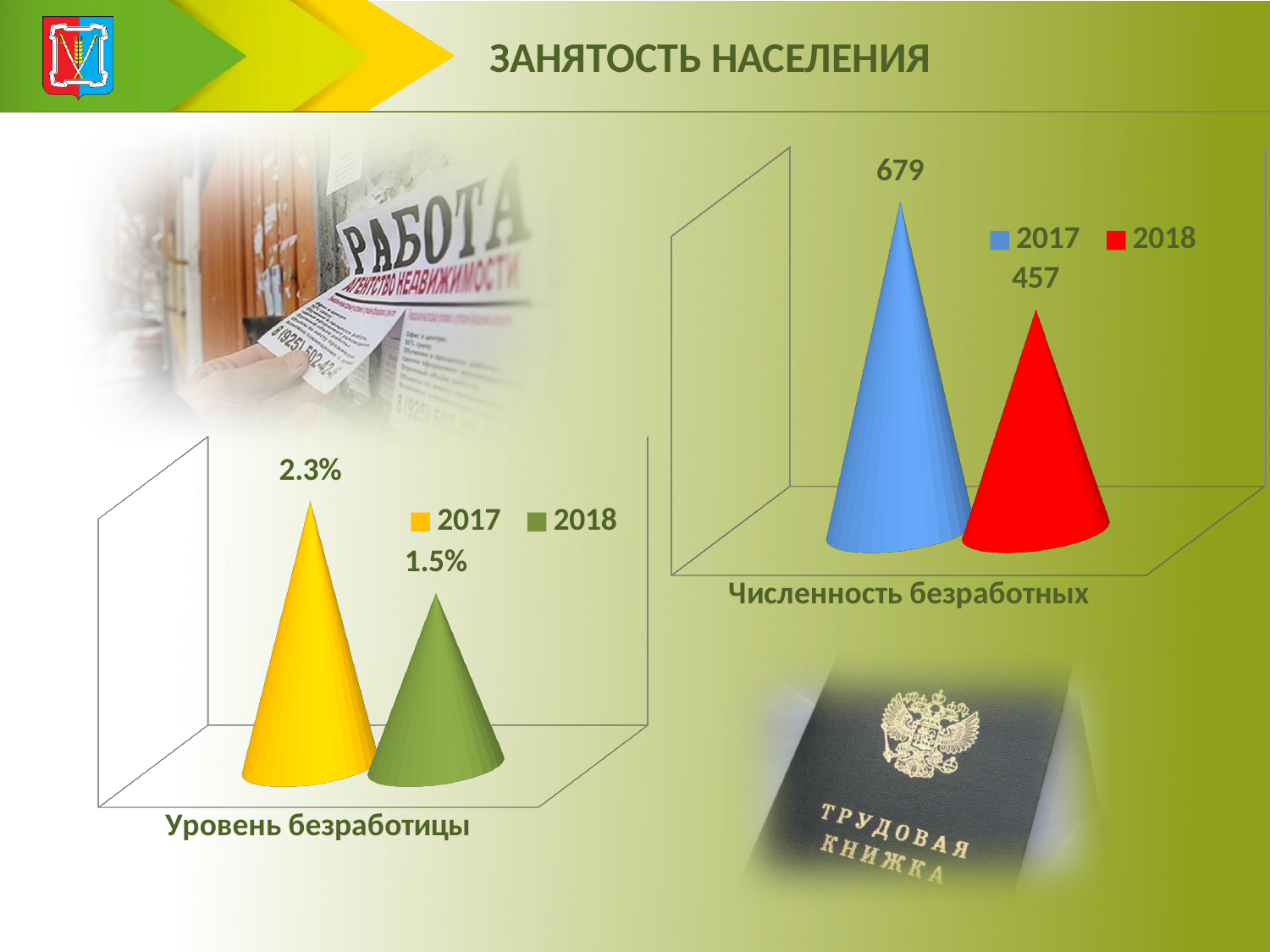
In the chart titled "Уровень безработицы", what is the difference between the 2017 and 2018 values? 0.8% How many series does the legend of the chart titled "Численность безработных" list? 2 In the chart titled "Численность безработных", what is the difference between the 2017 and 2018 values? 222 In the chart titled "Численность безработных", which year has the higher value? 2017 In the chart titled "Уровень безработицы", what is the value for 2017? 2.3% In the chart titled "Уровень безработицы", which year has the lower value? 2018 In the chart titled "Уровень безработицы", is the value for 2017 larger or smaller than the value for 2018? larger In the chart titled "Численность безработных", what is the value for 2018? 457 In the chart titled "Численность безработных", which colour represents 2018? red What kind of chart is the chart titled "Уровень безработицы"? bar chart In the chart titled "Численность безработных", what is the value for 2017? 679 In the chart titled "Уровень безработицы", what is the value for 2018? 1.5%